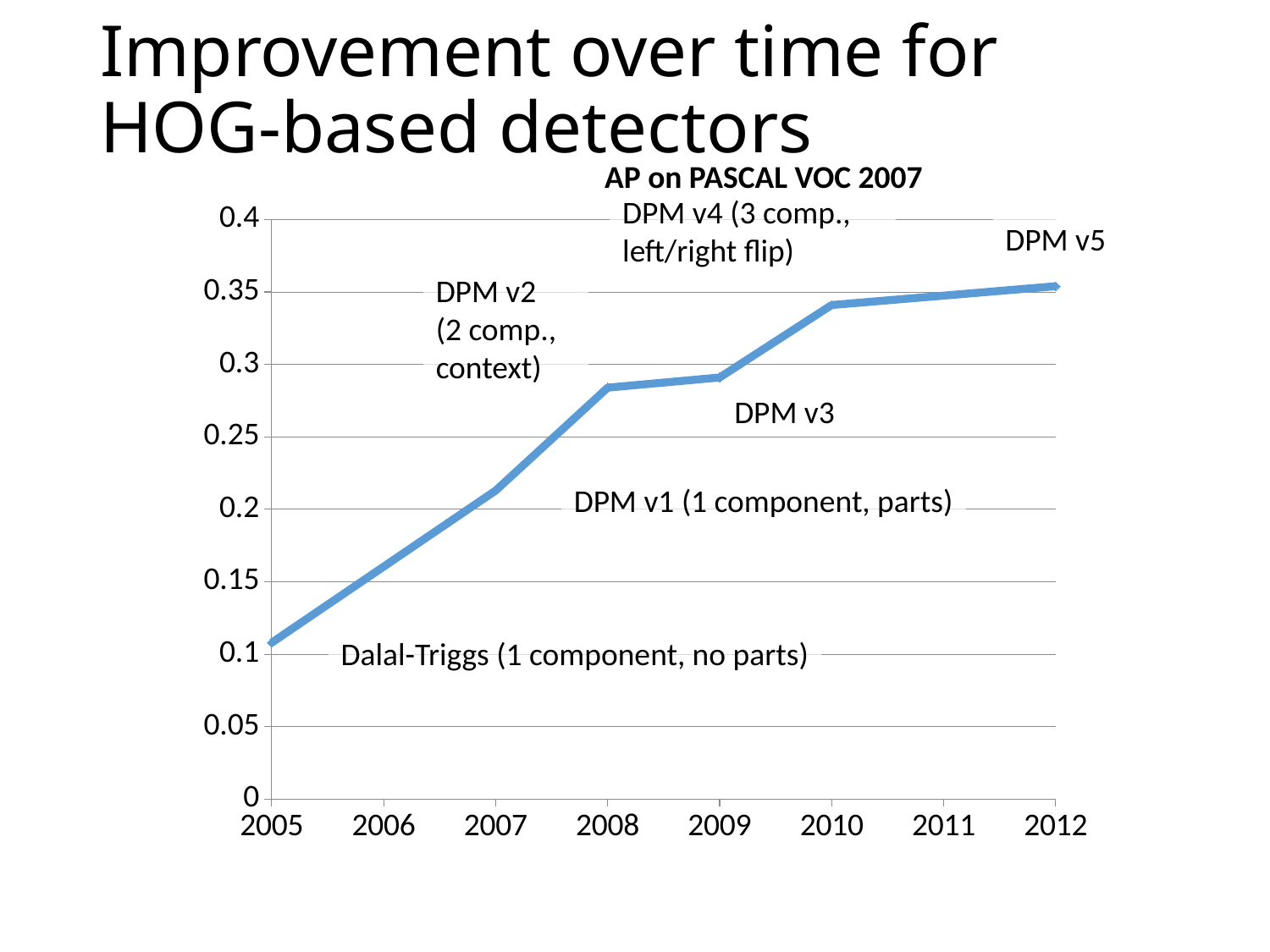
Is the AP value for 2005 greater or less than 0.15? less How many years are labeled on the x axis of the chart? 8 Do the AP values rise or fall from 2005 to 2012? rise Which year has the highest AP value on the chart? 2012 Which detector is annotated at the 2012 end of the line? DPM v5 Is the AP value for 2012 greater or less than 0.3? greater Which year has the larger AP value, 2008 or 2010? 2010 What is the title of the chart? AP on PASCAL VOC 2007 Is the AP value for 2010 greater or less than 0.3? greater Which year has the lowest AP value on the chart? 2005 What kind of chart is shown on the slide? line chart